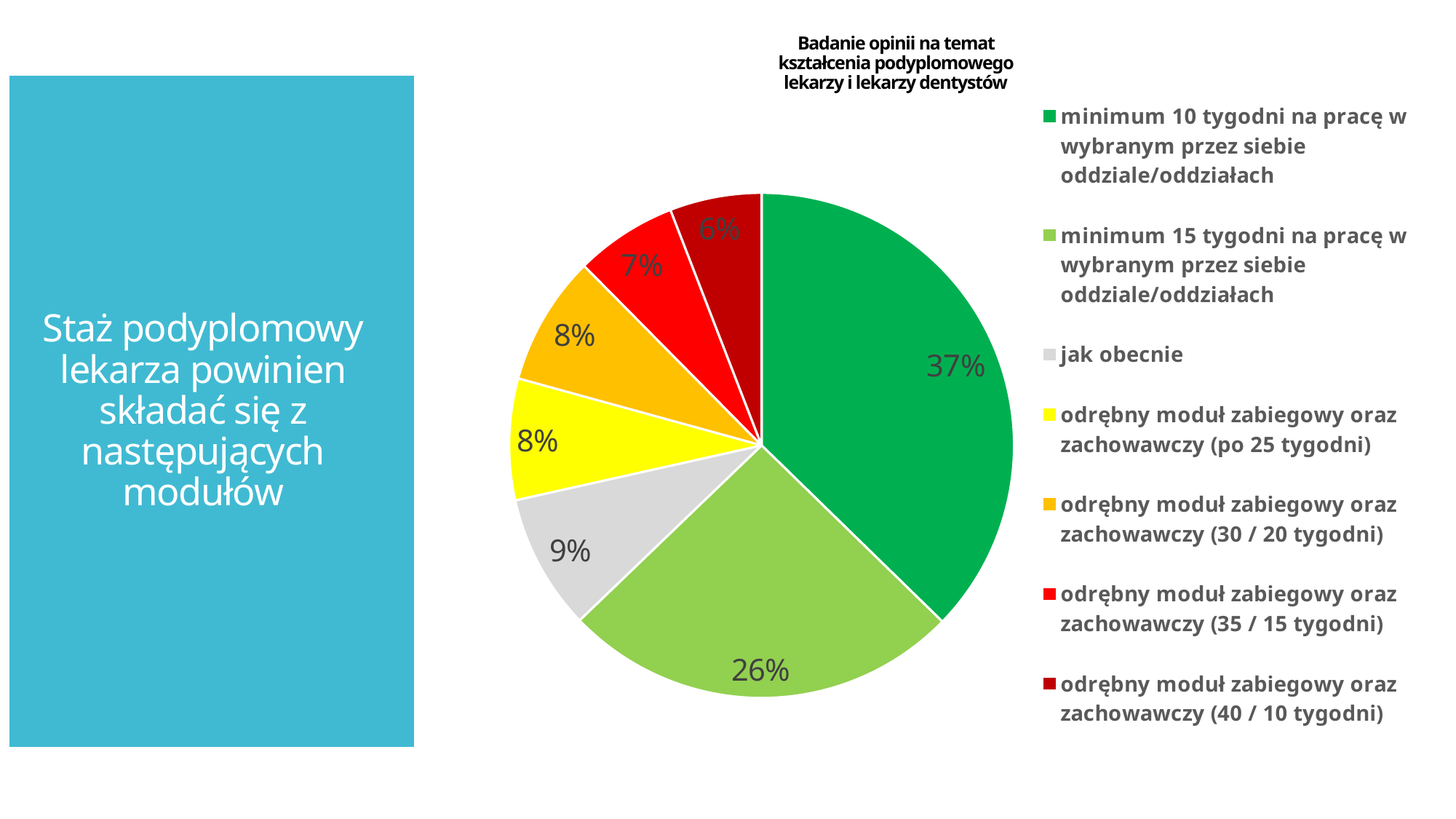
What share of the pie does "minimum 15 tygodni na pracę w wybranym przez siebie oddziale/oddziałach" have? 26% What is the value for "jak obecnie"? 9% What is the difference between the shares for "minimum 10 tygodni" and "minimum 15 tygodni"? 11% How many slices does the pie chart have? 7 What is the value for "odrębny moduł zabiegowy oraz zachowawczy (40 / 10 tygodni)"? 6% What is the title of the chart? Badanie opinii na temat kształcenia podyplomowego lekarzy i lekarzy dentystów What is the value for "odrębny moduł zabiegowy oraz zachowawczy (35 / 15 tygodni)"? 7% What kind of chart is shown on the slide? Pie chart Which category has the smallest slice of the pie? odrębny moduł zabiegowy oraz zachowawczy (40 / 10 tygodni) Which category has the largest slice of the pie? minimum 10 tygodni na pracę w wybranym przez siebie oddziale/oddziałach Which is larger: the share for "jak obecnie" or the share for "odrębny moduł zabiegowy oraz zachowawczy (35 / 15 tygodni)"? jak obecnie What share of the pie does "minimum 10 tygodni na pracę w wybranym przez siebie oddziale/oddziałach" have? 37%